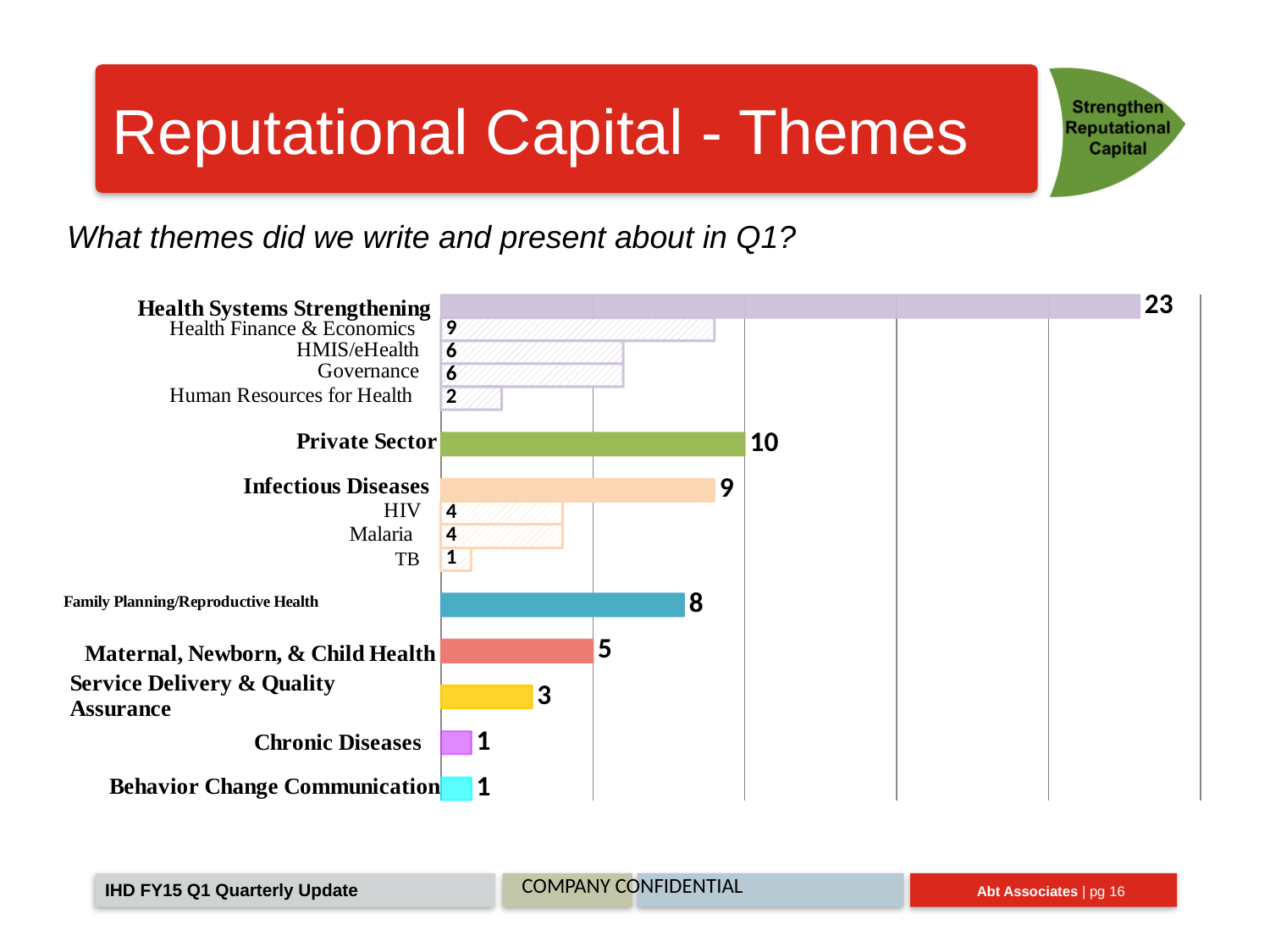
What is the value for TB? 1 How many sub-themes are listed under Infectious Diseases? 3 Which theme has the highest value? Health Systems Strengthening Which is larger, the value for Health Finance & Economics or the value for HMIS/eHealth? Health Finance & Economics What is the value for Human Resources for Health? 2 What is the value for Health Systems Strengthening? 23 What kind of chart is shown on the slide? Bar chart What is the value for Family Planning/Reproductive Health? 8 What is the difference between the values for Infectious Diseases and Maternal, Newborn, & Child Health? 4 What is the value for Private Sector? 10 What is the difference between the values for Health Systems Strengthening and Private Sector? 13 Which is larger, the value for Private Sector or the value for Infectious Diseases? Private Sector